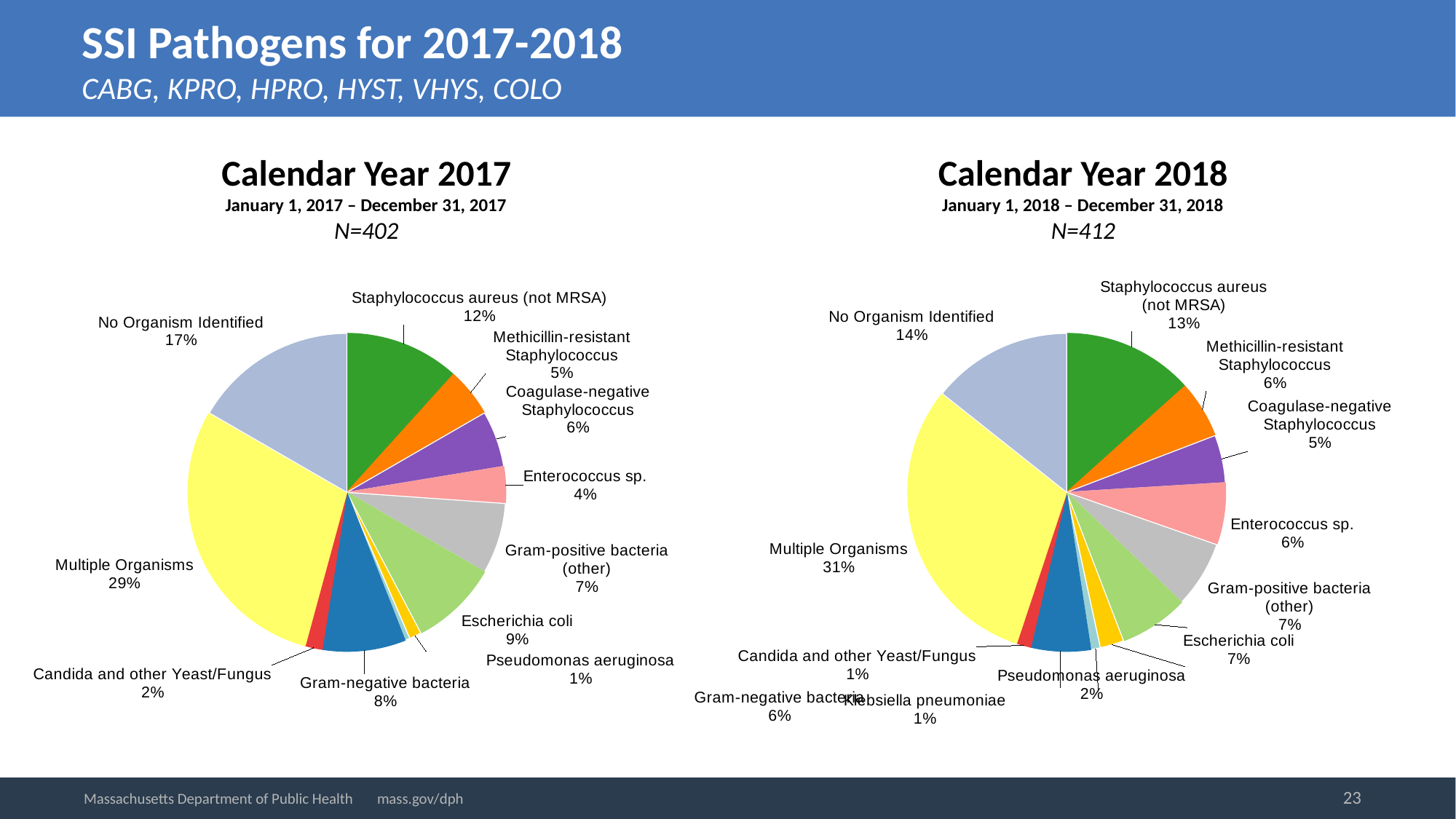
How many slices does the Calendar Year 2018 pie chart have? 12 In the Calendar Year 2017 chart, what share is Escherichia coli? 9% In the Calendar Year 2018 chart, which is larger: the share for Enterococcus sp. or the share for Coagulase-negative Staphylococcus? Enterococcus sp. In the Calendar Year 2017 chart, what share of SSI pathogens is Multiple Organisms? 29% In the Calendar Year 2018 chart, what share is No Organism Identified? 14% In the Calendar Year 2018 chart, which category has the largest share? Multiple Organisms What is the N value shown for the Calendar Year 2018 chart? N=412 In the Calendar Year 2017 chart, what is the difference between the shares for No Organism Identified and Staphylococcus aureus (not MRSA)? 5% In the Calendar Year 2017 chart, what is the difference between the shares for Gram-negative bacteria and Candida and other Yeast/Fungus? 6% What kind of chart is used for Calendar Year 2017? Pie chart In the Calendar Year 2018 chart, what share is Klebsiella pneumoniae? 1%